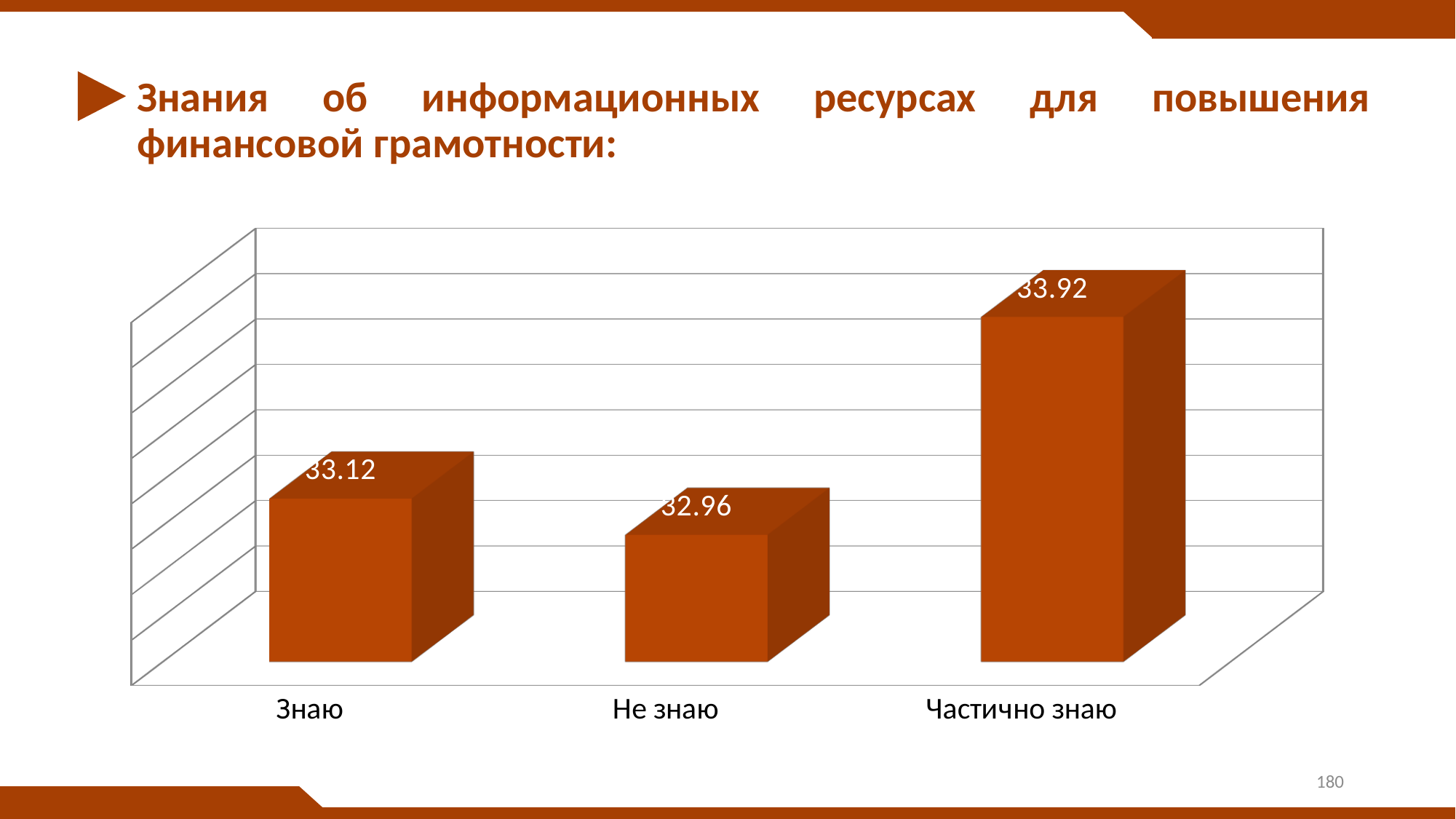
Which category has the highest value? Частично знаю What kind of chart is shown on the slide? Bar chart Which category has the lowest value? Не знаю What is the value for the category "Знаю"? 33.12 How many categories are shown on the chart? 3 What is the difference between the values for "Знаю" and "Не знаю"? 0.16 Which is larger, the value for "Знаю" or the value for "Не знаю"? Знаю What is the value for the category "Не знаю"? 32.96 What is the difference between the values for "Частично знаю" and "Не знаю"? 0.96 What is the title text above the chart on the slide? Знания об информационных ресурсах для повышения финансовой грамотности: What is the difference between the values for "Частично знаю" and "Знаю"? 0.80 What is the value for the category "Частично знаю"? 33.92